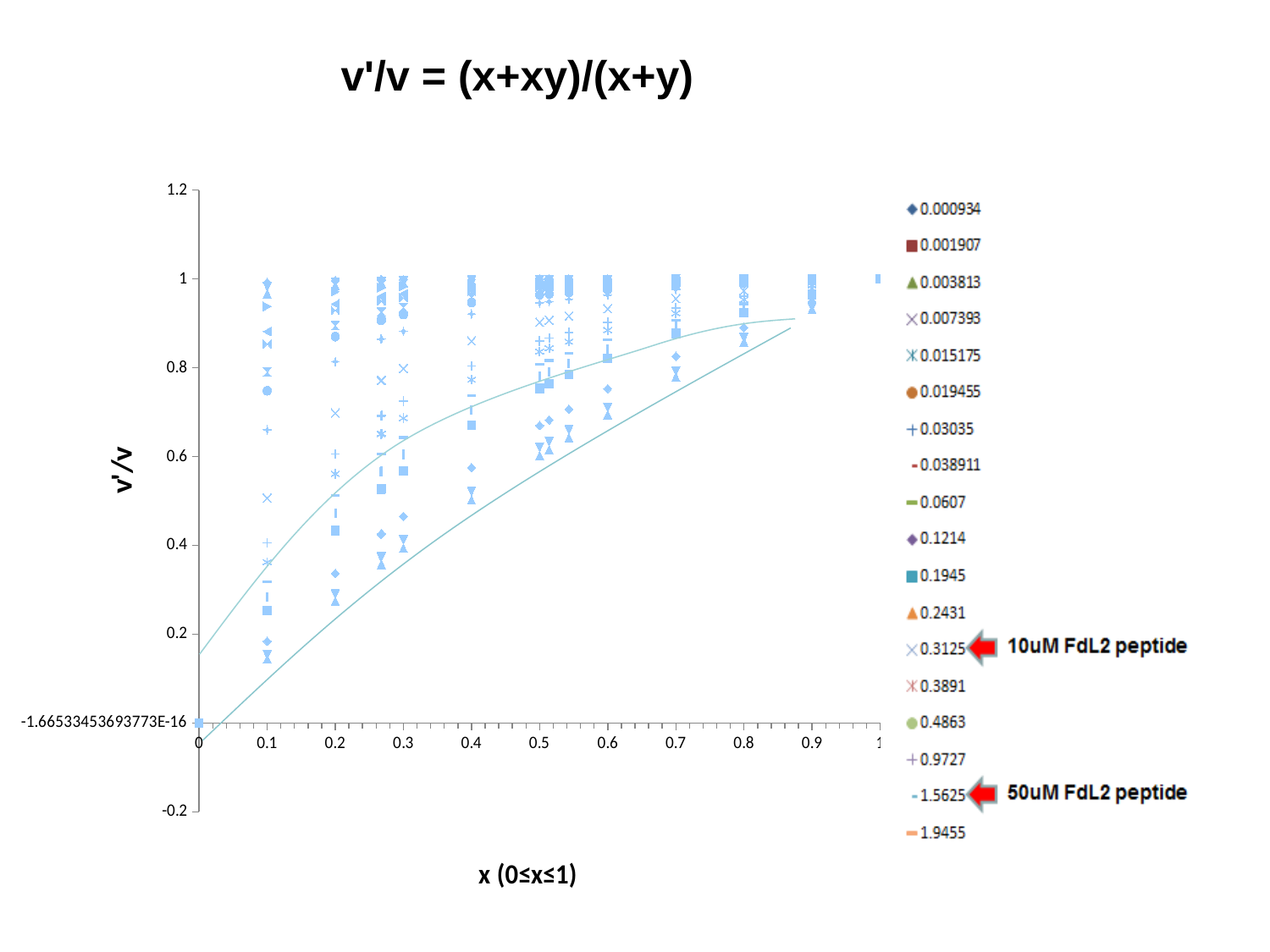
Do the plotted v'/v values generally rise or fall as x increases from 0 to 1? rise What kind of chart is shown on the slide? scatter chart What is the title of the chart? v'/v = (x+xy)/(x+y) Which legend entry does the arrow labelled '10uM FdL2 peptide' point to? 0.3125 How many series does the legend list? 18